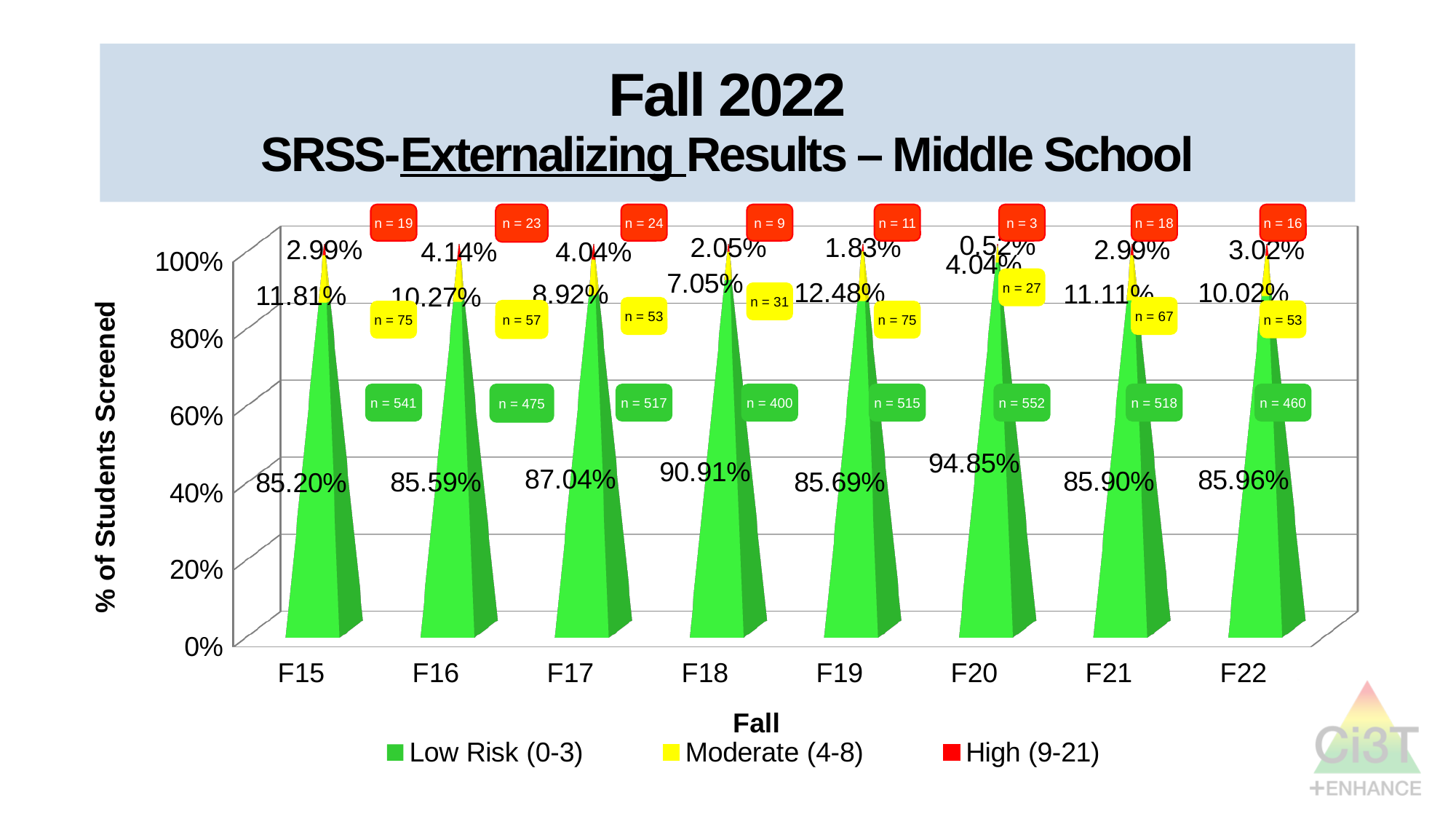
What is the Low Risk (0-3) percentage for F20? 94.85% Which fall has the highest Low Risk (0-3) percentage? F20 Which is larger, the Moderate (4-8) percentage for F15 or for F21? F15 Which colour represents the High (9-21) series in the legend? Red What is the Moderate (4-8) percentage for F19? 12.48% What is the difference between the Low Risk (0-3) percentage for F18 and for F15? 5.71% How many students were in the Low Risk (0-3) group in F18? n = 400 What is the High (9-21) percentage for F16? 4.14% How many fall screening periods are shown on the x axis? 8 Which fall has the lowest High (9-21) percentage? F20 What kind of chart is shown on the slide? Stacked bar chart How many series does the legend list? 3